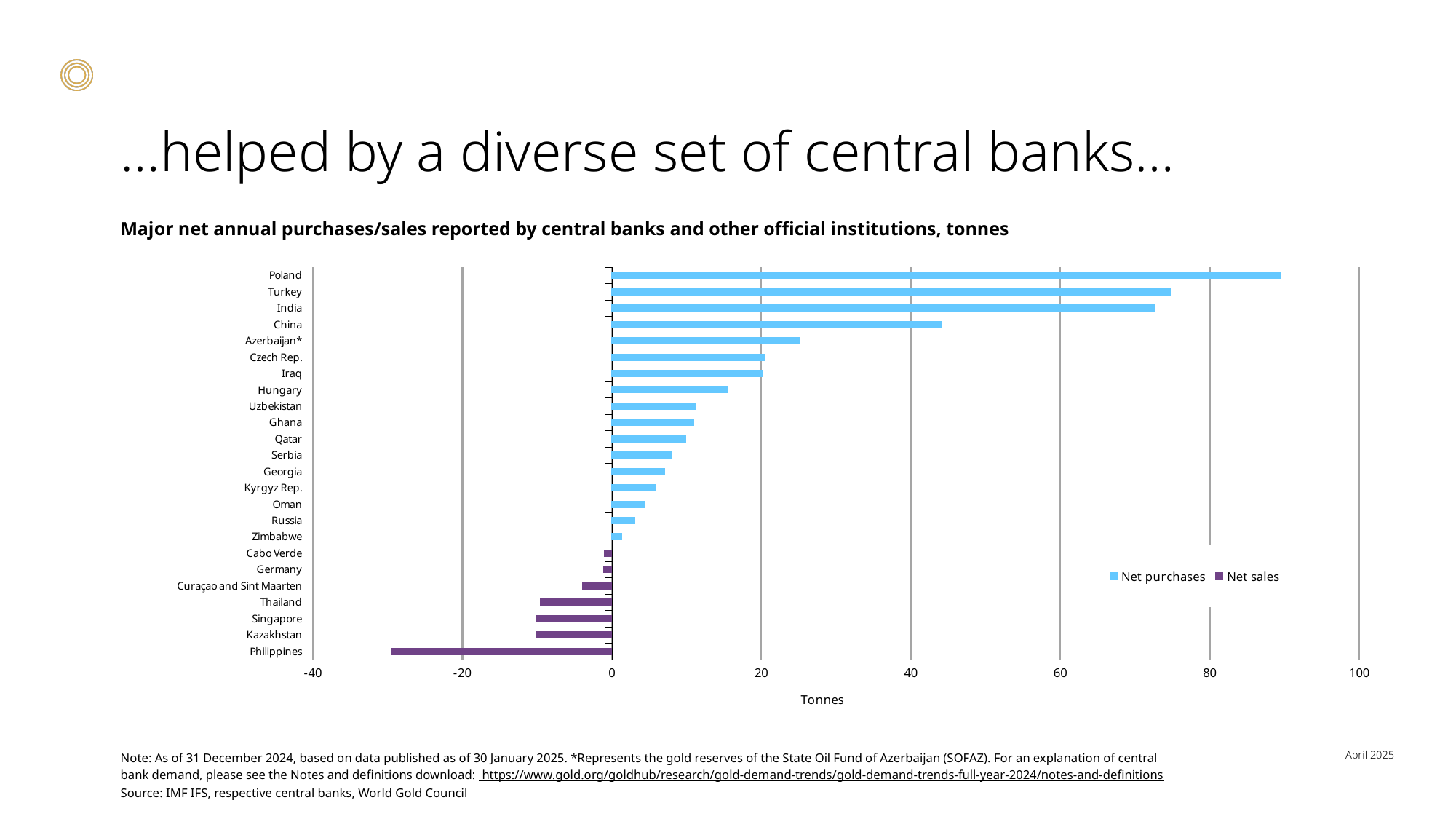
Which central bank has the highest net purchases on the chart? Poland What are the two entries in the chart's legend? Net purchases, Net sales Which central bank has the largest net sales (lowest value) on the chart? Philippines Which is larger, the value for Poland or the value for China? Poland Is the value for China greater or less than 40? greater What kind of chart is shown on the slide? bar chart Is the value for Poland greater or less than 80? greater Is the value for Philippines greater or less than -20? less Which is larger, the value for Hungary or the value for Uzbekistan? Hungary How many series does the legend list? 2 How many central banks or institutions are listed on the chart? 24